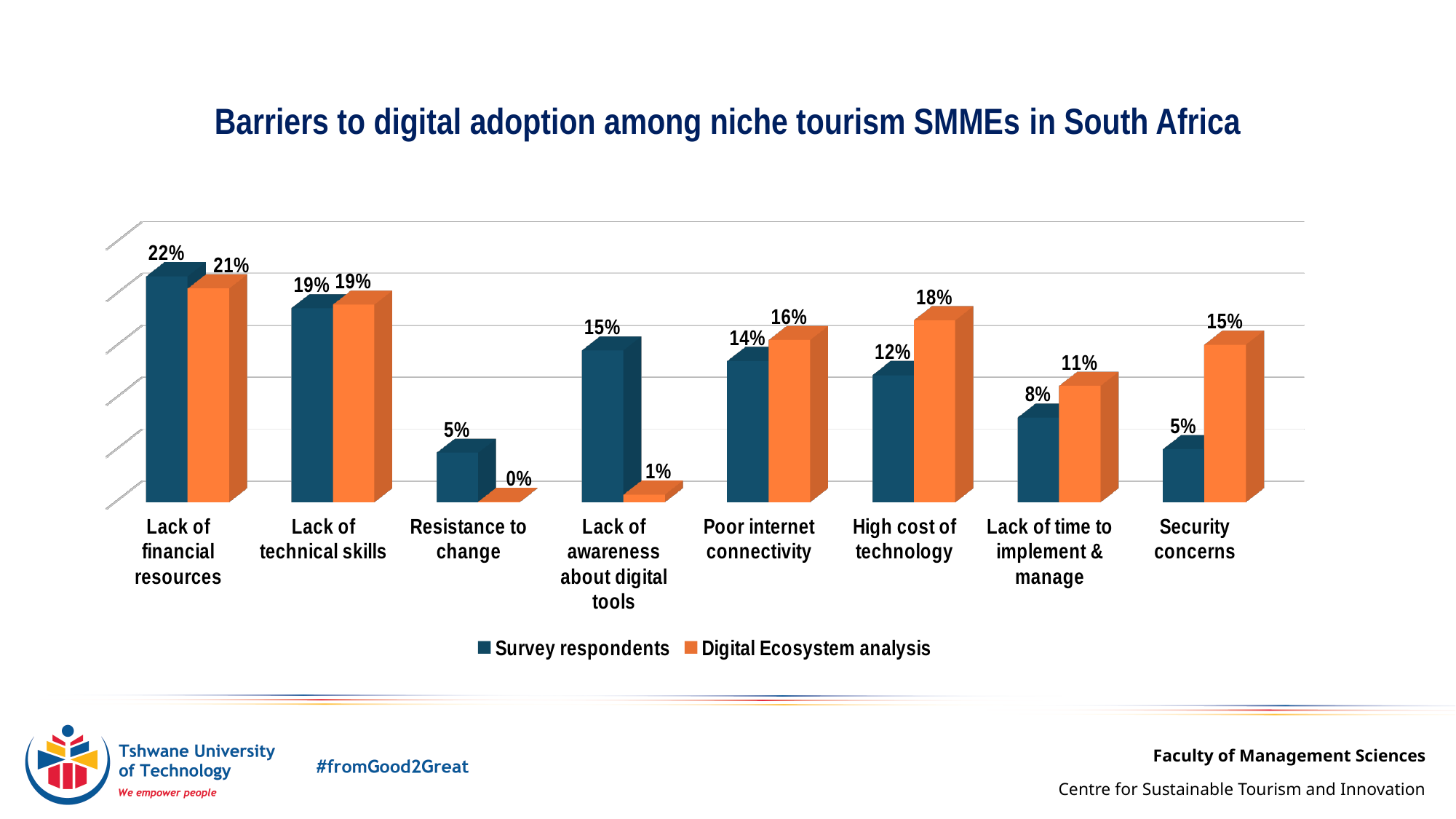
Which category has the lowest Digital Ecosystem analysis value? Resistance to change What kind of chart is shown on the slide? Bar chart How many categories are shown on the x axis? 8 What is the Digital Ecosystem analysis value for Security concerns? 15% How many series does the legend list? 2 For High cost of technology, which series has the larger value: Survey respondents or Digital Ecosystem analysis? Digital Ecosystem analysis What is the title of the chart? Barriers to digital adoption among niche tourism SMMEs in South Africa Which category has the highest Survey respondents value? Lack of financial resources Which colour represents the Digital Ecosystem analysis series? Orange What is the difference between the Survey respondents and Digital Ecosystem analysis values for Lack of awareness about digital tools? 14% What is the Survey respondents value for Lack of financial resources? 22% What is the Digital Ecosystem analysis value for Resistance to change? 0%